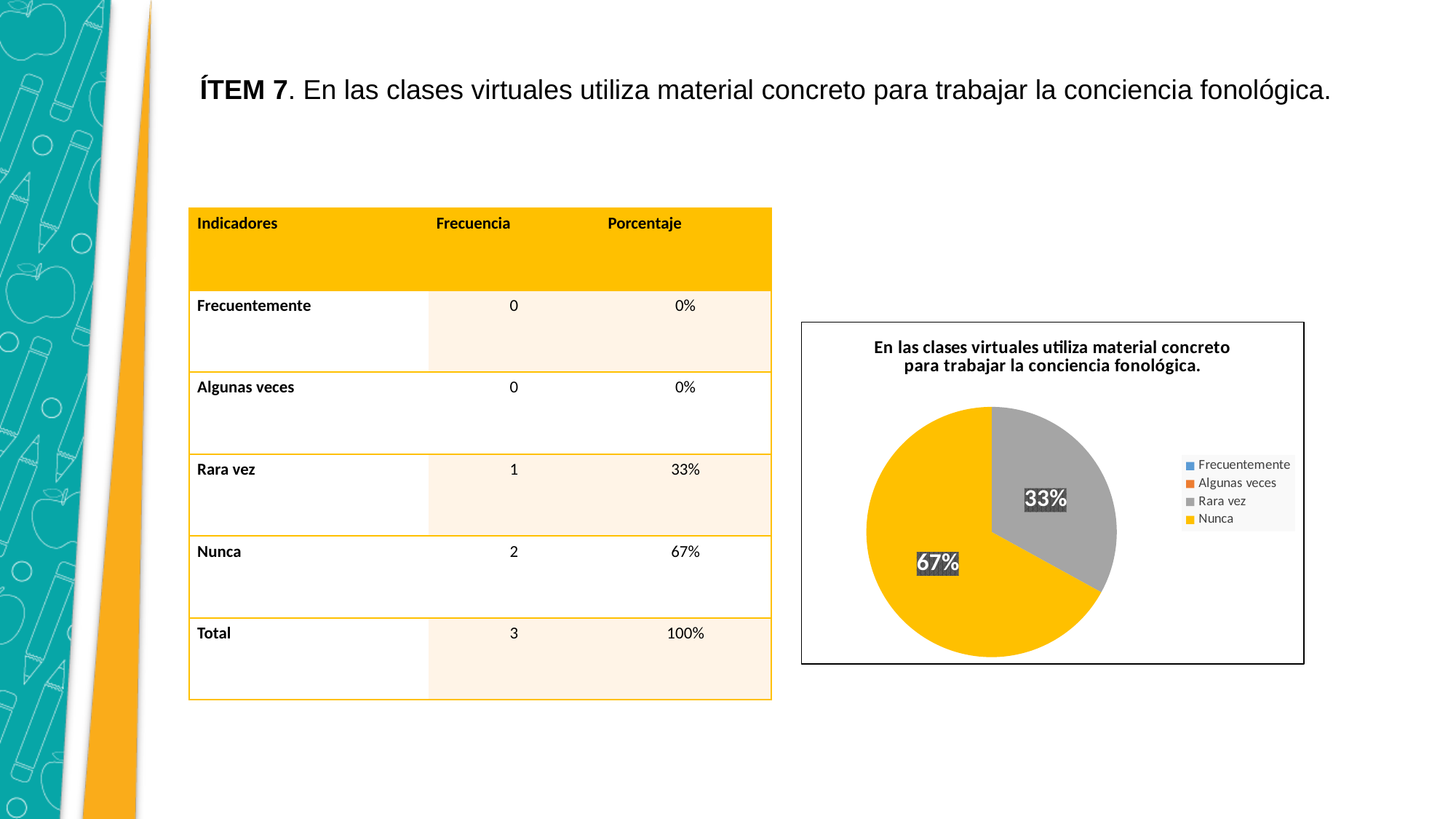
How many entries does the legend of the pie chart list? 4 Is the value for Nunca in the pie chart greater or less than 50%? greater What is the value shown for Rara vez in the pie chart? 33% Which category has the largest slice in the pie chart? Nunca How many slices are visible in the pie chart? 2 What is the title of the pie chart? En las clases virtuales utiliza material concreto para trabajar la conciencia fonológica. What is the difference between the Nunca and Rara vez percentages in the pie chart? 34% What kind of chart is shown on the slide? pie chart What is the value shown for Nunca in the pie chart? 67% What colour is the Nunca slice in the pie chart? yellow Which of the two visible slices is larger, Rara vez or Nunca? Nunca